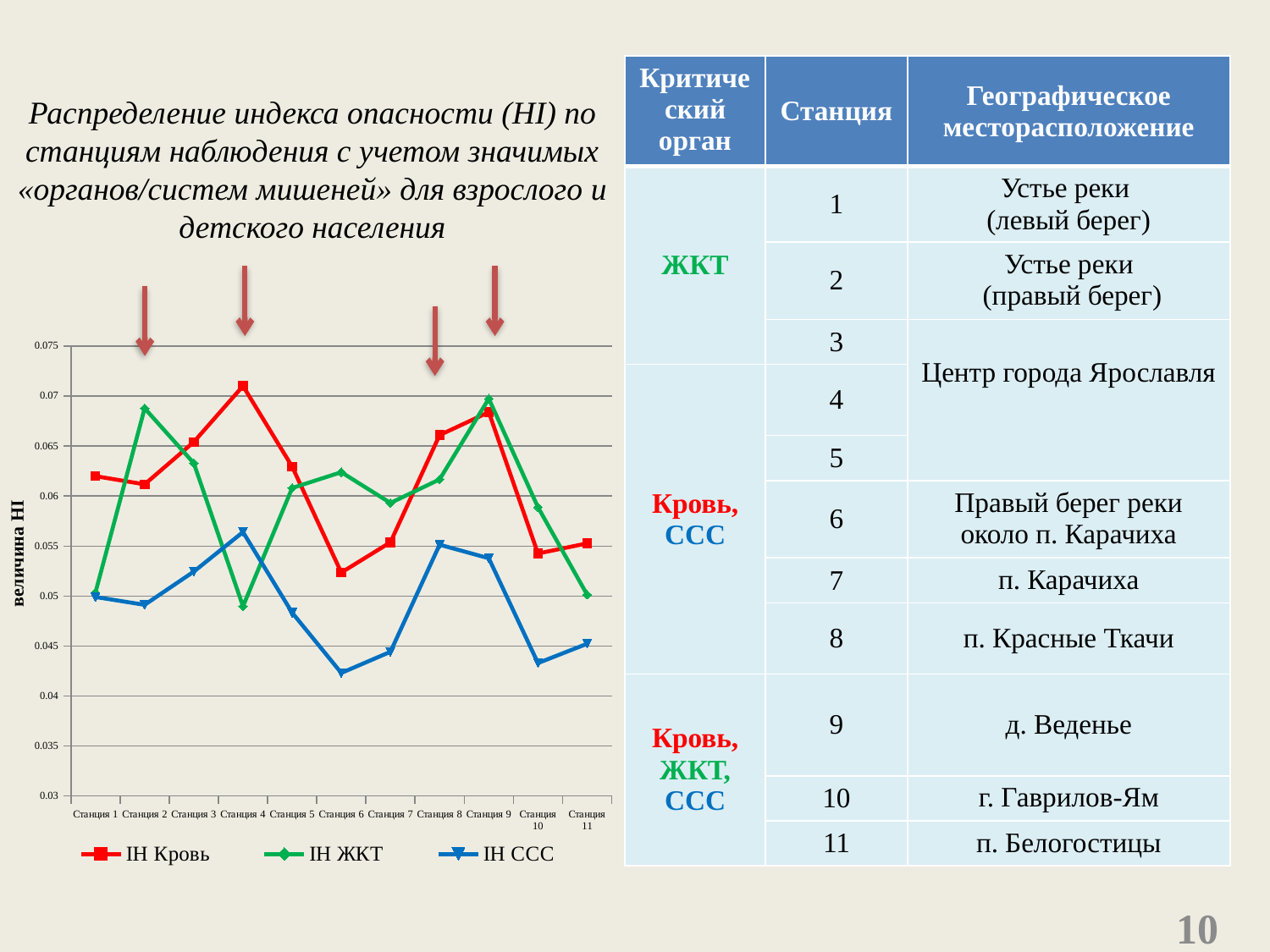
How many series does the chart legend list? 3 At which station does the IH ССС series reach its lowest value? Станция 6 At which station does the IH Кровь series reach its highest value? Станция 4 Is the IH ЖКТ value at Станция 2 greater or less than 0.065? greater At Станция 4, which series has the larger value, IH Кровь or IH ЖКТ? IH Кровь Does the IH ССС series rise or fall from Станция 4 to Станция 6? fall Is the IH Кровь value at Станция 6 greater or less than 0.055? less What is the label on the y axis of the chart? величина HI Is the IH ССС value at Станция 6 greater or less than 0.045? less At which station does the IH Кровь series reach its lowest value? Станция 6 What kind of chart is shown on the slide? line chart How many stations are plotted along the x axis of the chart? 11